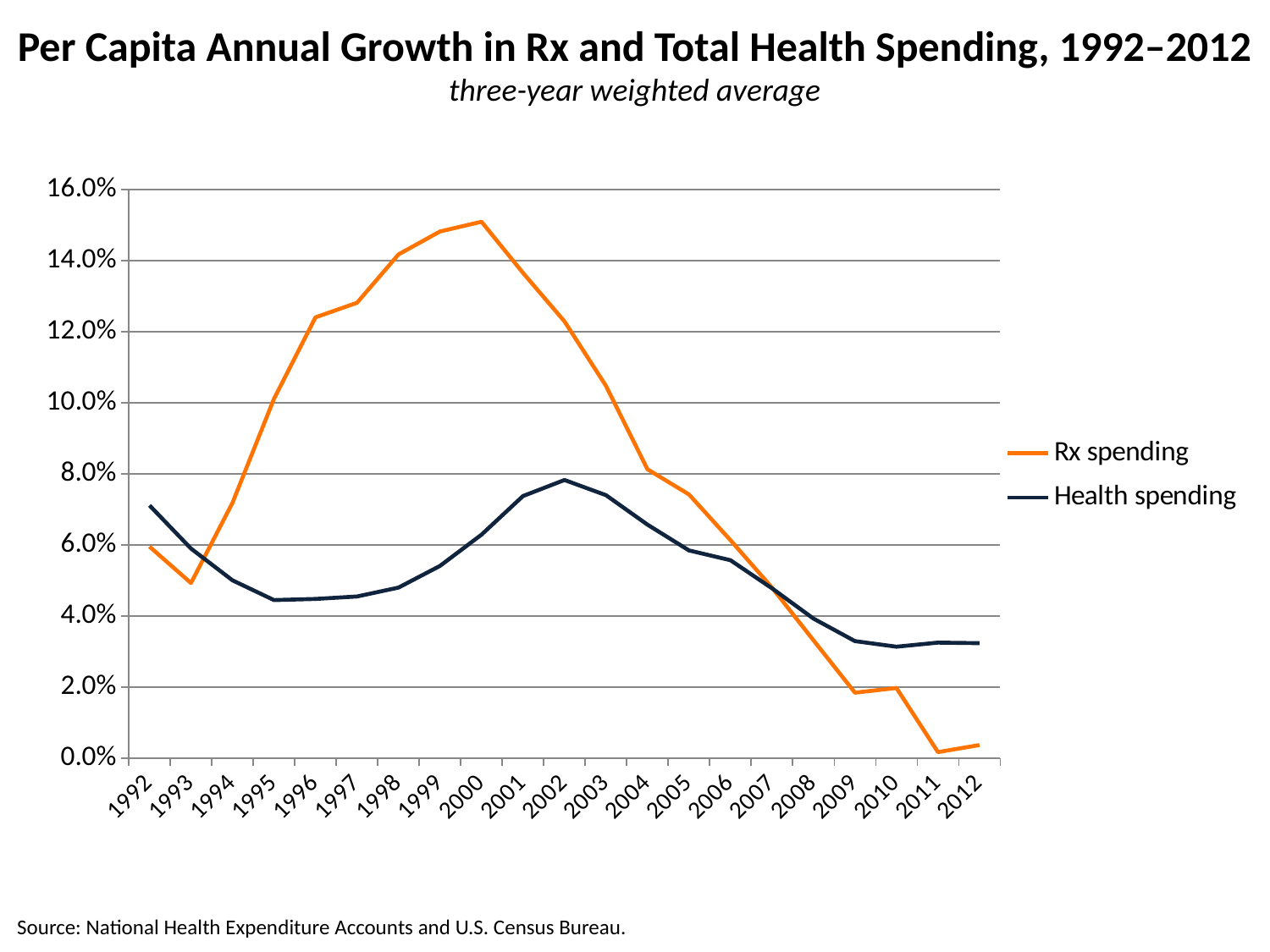
In which year does Health spending growth reach its highest value? 2002 How many series does the legend list? 2 Is the value for Rx spending in 2011 greater or less than 2.0%? less In 2009, which series has the higher growth value, Rx spending or Health spending? Health spending In which year does Rx spending growth reach its lowest value? 2011 In 1992, which series has the higher growth value, Rx spending or Health spending? Health spending What kind of chart is shown on the slide? line chart Is the value for Health spending in 1995 greater or less than 6.0%? less Is the value for Rx spending in 2000 greater or less than 14.0%? greater In which year does Rx spending growth reach its highest value? 2000 Does Rx spending growth rise or fall from 2000 to 2011? fall How many years are plotted along the x axis? 21